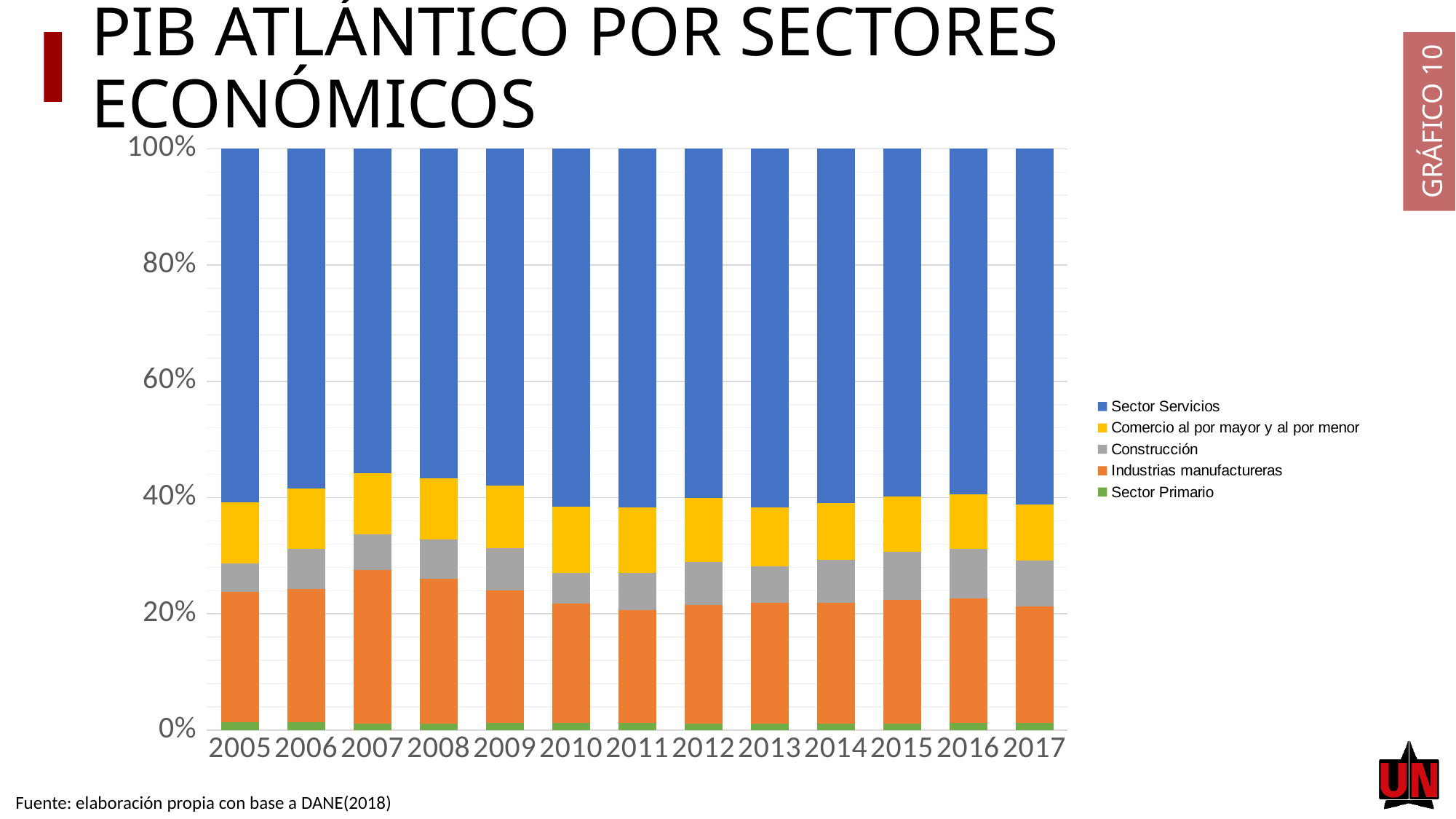
Which is larger in 2005, the Comercio al por mayor y al por menor segment or the Construcción segment? Comercio al por mayor y al por menor Is the share of Sector Servicios in 2010 greater or less than 50%? greater Is the share of Industrias manufactureras in 2007 greater or less than 20%? greater In which year is the Industrias manufactureras segment the largest? 2007 Which colour represents Sector Servicios in the chart? Blue What kind of chart is shown on the slide? Stacked bar chart How many years are shown on the x axis of the chart? 13 Is the share of Sector Primario in 2005 greater or less than 20%? less Which is larger, the Industrias manufactureras segment in 2007 or in 2011? 2007 What is the title of the chart on the slide? PIB ATLÁNTICO POR SECTORES ECONÓMICOS How many series does the chart's legend list? 5